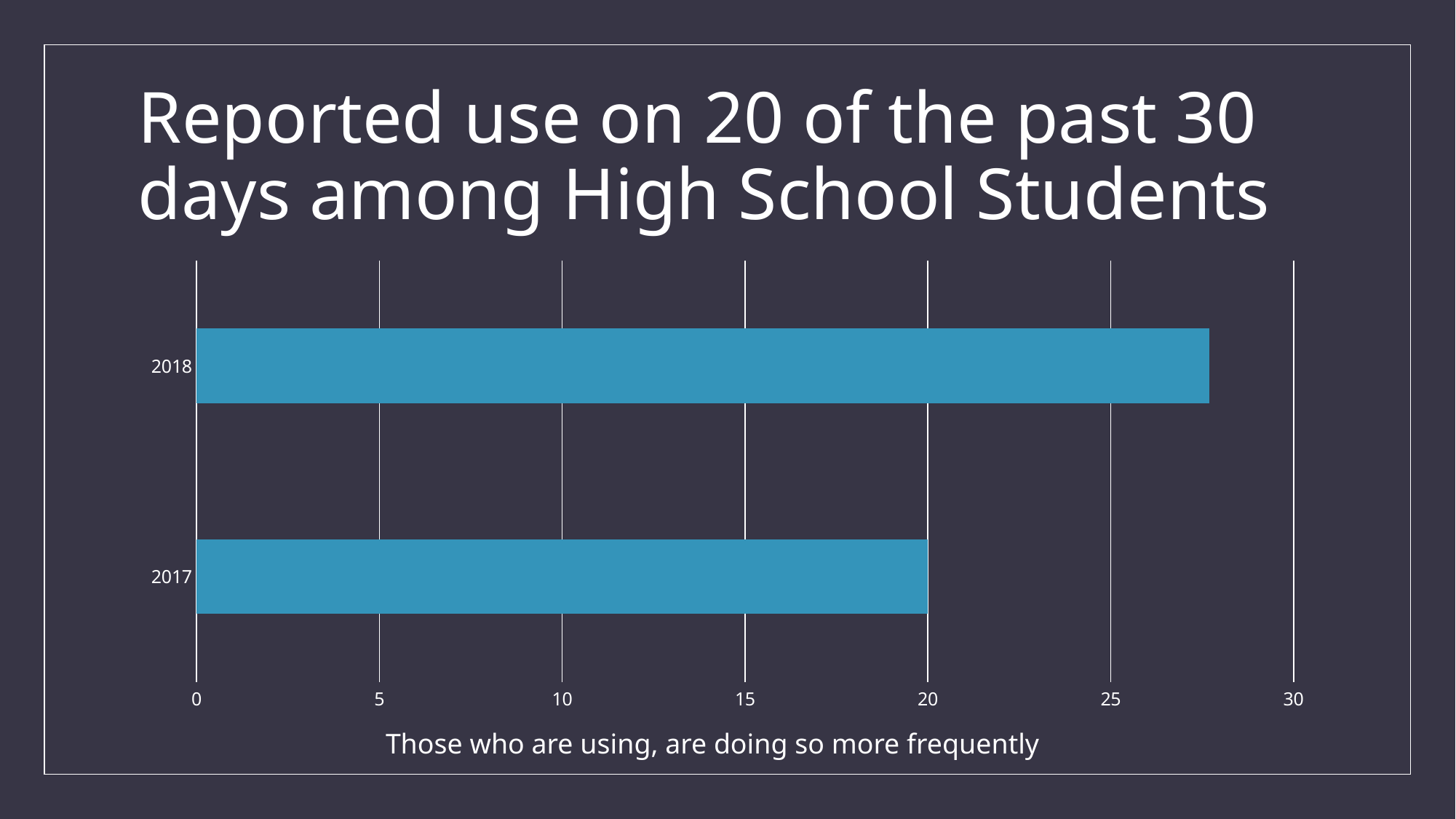
Which is larger, the value for 2017 or the value for 2018? 2018 Which year has the lowest value? 2017 Is the value for 2018 greater or less than 30? less What kind of chart is shown on the slide? bar chart What is the title of the chart? Reported use on 20 of the past 30 days among High School Students How many years are shown in the chart? 2 What text appears below the horizontal axis of the chart? Those who are using, are doing so more frequently Did the value rise or fall from 2017 to 2018? rise What is the value for 2017? 20 Is the value for 2018 greater or less than 25? greater Which year has the highest value? 2018